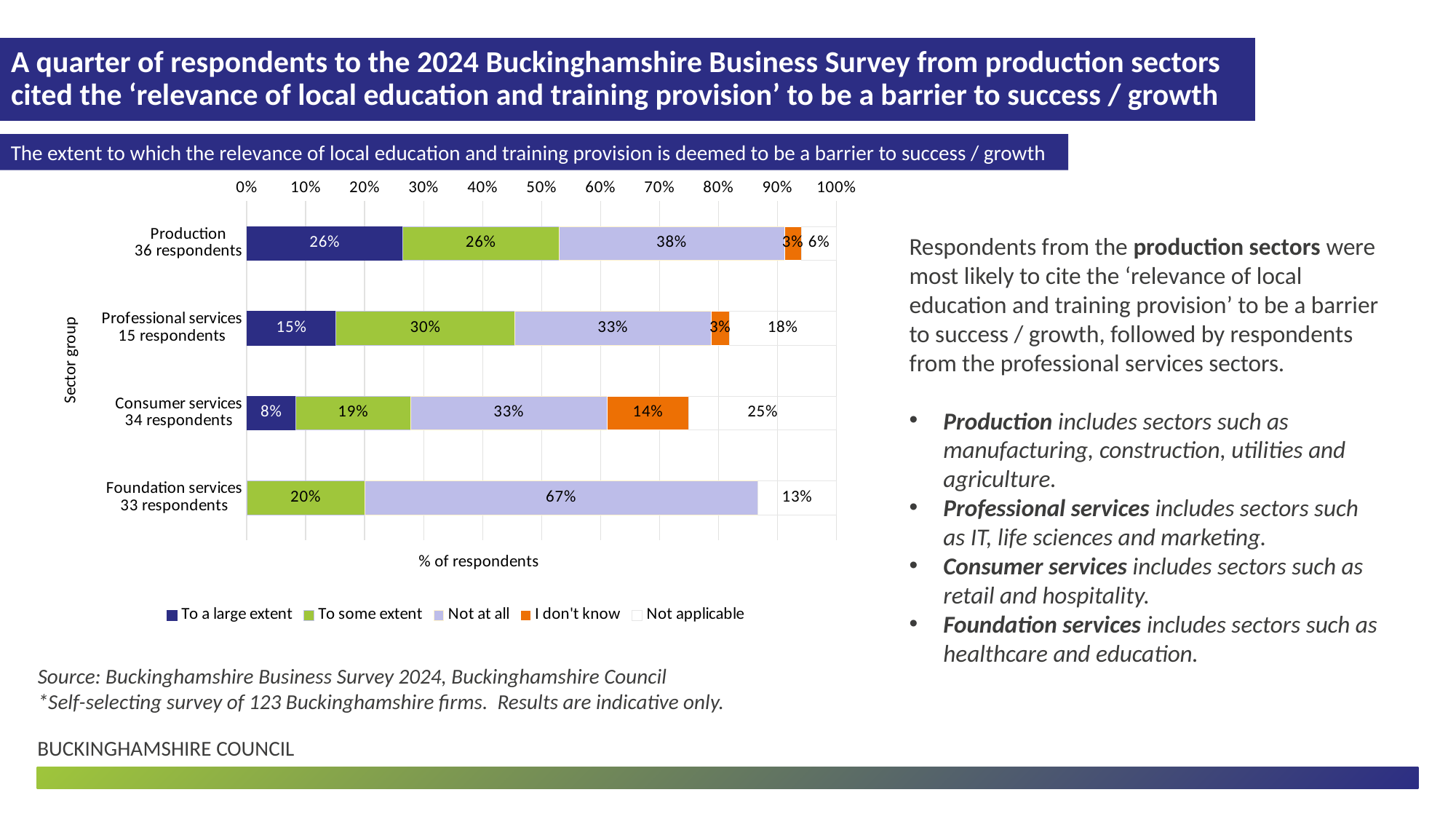
How many series does the legend list? 5 Which is larger: the 'Not at all' percentage for Production or for Professional services? Production How many sector groups are shown on the chart? 4 What percentage of Professional services respondents answered 'Not applicable'? 18% What kind of chart is shown on the slide? Stacked bar chart What percentage of Foundation services respondents answered 'Not at all'? 67% What is the difference between the 'To some extent' percentages for Professional services and Consumer services? 11% What percentage of Consumer services respondents answered 'I don't know'? 14% How many respondents are in the Consumer services sector group? 34 Which sector group has the lowest 'To some extent' percentage? Consumer services Which sector group has the highest 'To a large extent' percentage? Production What percentage of Production respondents said the relevance of local education and training provision is a barrier 'To a large extent'? 26%